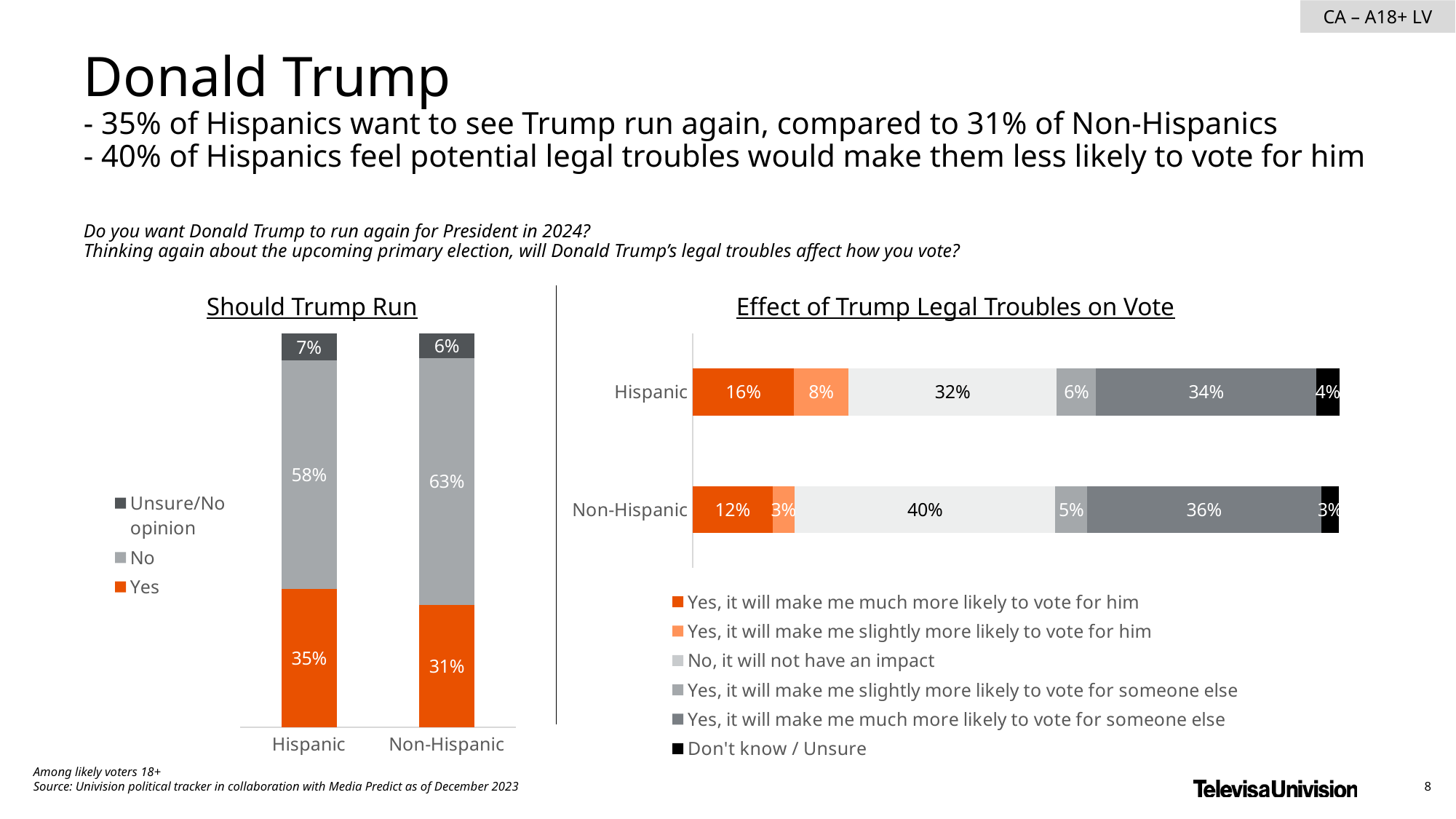
In the 'Should Trump Run' chart, which group has the larger Unsure/No opinion share, Hispanic or Non-Hispanic? Hispanic In the 'Should Trump Run' chart, what is the difference between the Yes share for Hispanics and for Non-Hispanics? 4% In the 'Should Trump Run' chart, what is the total of the Hispanic stacked bar? 100% In the 'Effect of Trump Legal Troubles on Vote' chart, what is the difference between the 'much more likely to vote for him' share for Hispanics and Non-Hispanics? 4% In the 'Should Trump Run' chart, how many series does the legend list? 3 In the 'Effect of Trump Legal Troubles on Vote' chart, which response has the largest share among Hispanics? Yes, it will make me much more likely to vote for someone else In the 'Effect of Trump Legal Troubles on Vote' chart, what percentage of Hispanics said it will make them much more likely to vote for someone else? 34% In the 'Effect of Trump Legal Troubles on Vote' chart, what percentage of Non-Hispanics said it will not have an impact? 40% What kind of chart is the 'Effect of Trump Legal Troubles on Vote' chart? Stacked bar chart In the 'Should Trump Run' chart, what percentage of Non-Hispanics answered No? 63% In the 'Effect of Trump Legal Troubles on Vote' chart, how many series does the legend list? 6 In the 'Should Trump Run' chart, what percentage of Hispanics answered Yes? 35%